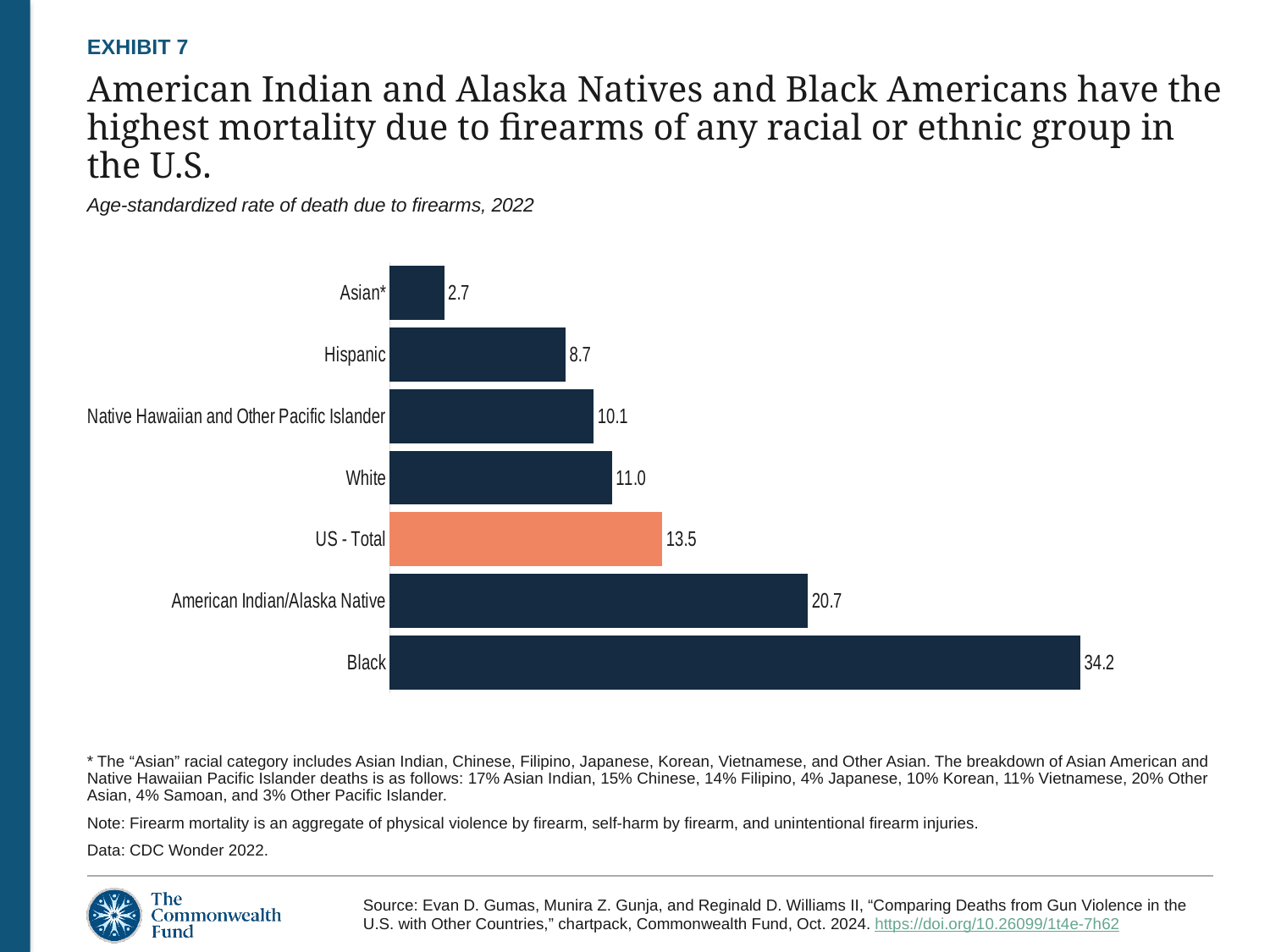
Which is larger, the value for White or the value for Hispanic? White What is the age-standardized rate of death due to firearms for Black Americans? 34.2 How many categories are shown in the chart? 7 What is the value shown for Hispanic? 8.7 Which group has the lowest rate of death due to firearms? Asian* What is the value shown for Native Hawaiian and Other Pacific Islander? 10.1 Which group has the highest rate of death due to firearms? Black What is the difference between the values for White and Asian*? 8.3 What kind of chart is shown on the slide? Bar chart Which bar is shown in a different colour (orange) from the others? US - Total What is the difference between the values for Black and American Indian/Alaska Native? 13.5 What is the value shown for the US - Total bar? 13.5